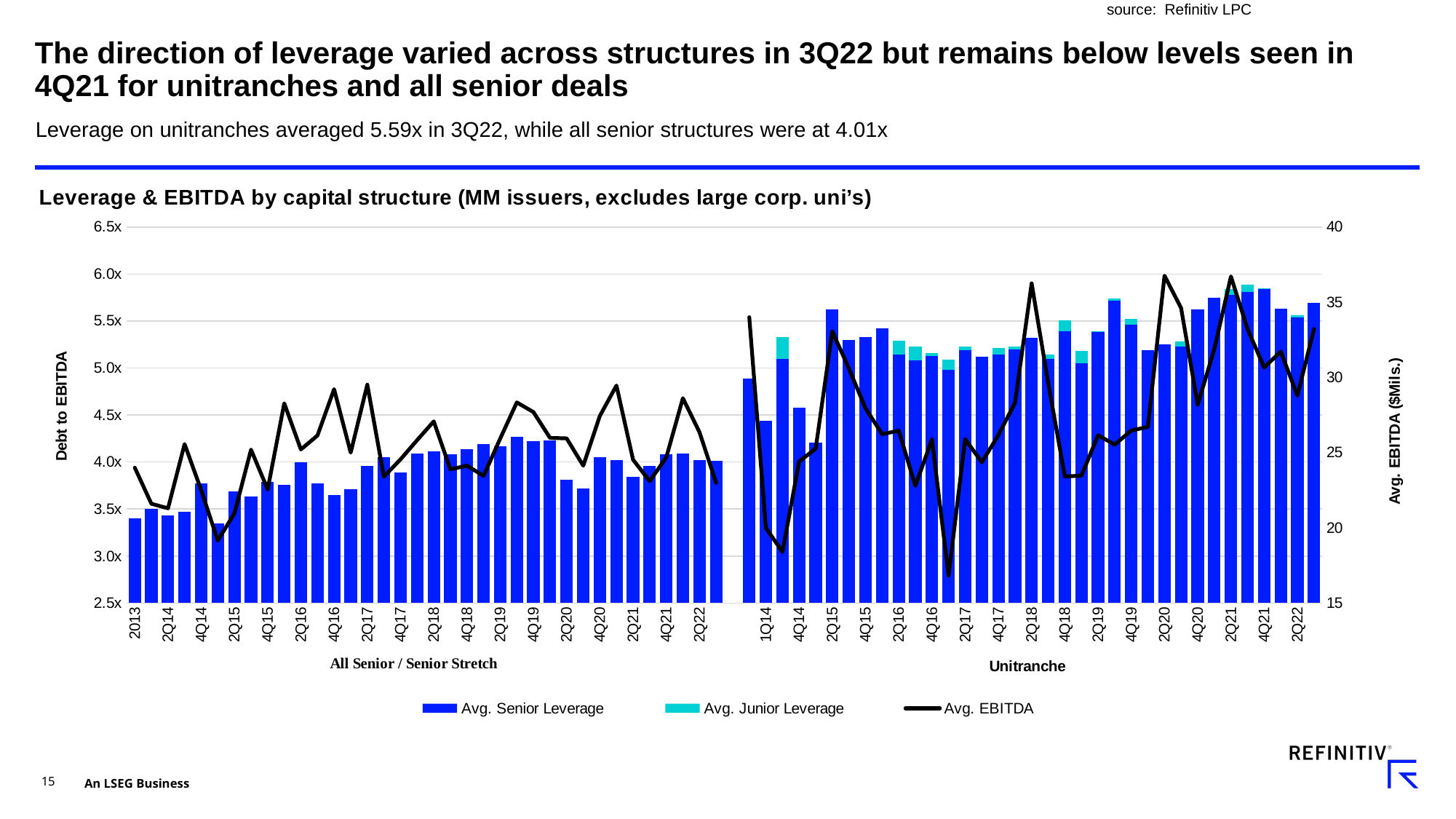
In the Unitranche group, is the Avg. Senior Leverage for 4Q14 greater or less than 5.0x? less In the Unitranche group, is the Avg. Senior Leverage for 2Q15 greater or less than 5.5x? greater How many capital structure groups are shown along the x axis? 2 In the All Senior / Senior Stretch group, is the Avg. Senior Leverage for 4Q16 greater or less than 4.0x? less How many series does the legend list? 3 Which is larger, the Avg. Senior Leverage for 2Q15 in the Unitranche group or for 2Q15 in the All Senior / Senior Stretch group? Unitranche 2Q15 What is the title of the chart? Leverage & EBITDA by capital structure (MM issuers, excludes large corp. uni's) In the Unitranche group, does the Avg. EBITDA line rise or fall from 1Q14 to 4Q14? rise What kind of chart is shown on the slide? Bar chart with a line What are the three series listed in the legend? Avg. Senior Leverage, Avg. Junior Leverage, Avg. EBITDA